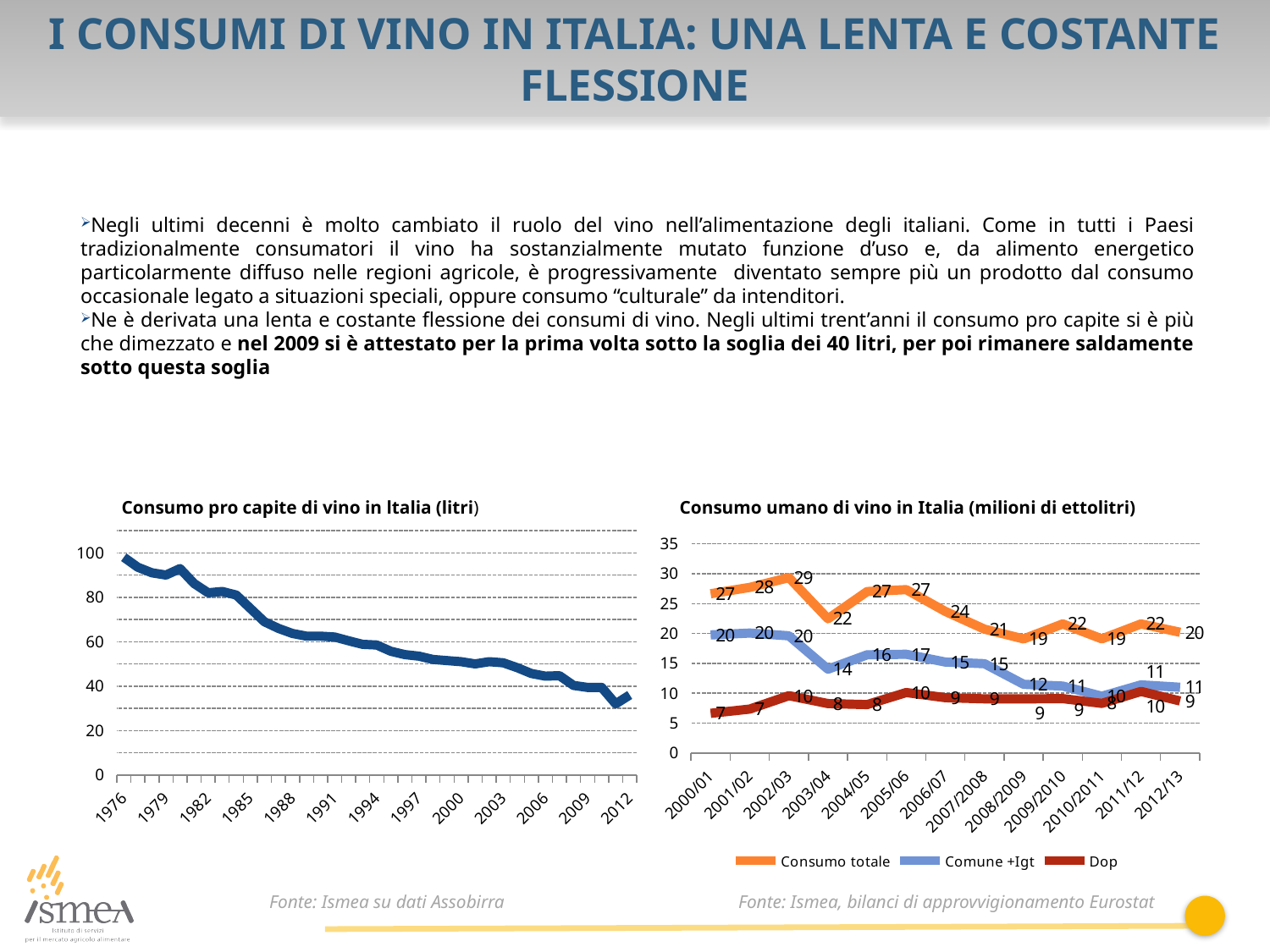
How many series does the legend of the chart 'Consumo umano di vino in Italia (milioni di ettolitri)' list? 3 In the chart 'Consumo umano di vino in Italia (milioni di ettolitri)', in which year does Consumo totale reach its highest value? 2002/03 How many years are plotted on the x axis of the chart 'Consumo umano di vino in Italia (milioni di ettolitri)'? 13 In the chart 'Consumo pro capite di vino in Italia (litri)', do the values rise or fall from 1976 to 2012? fall In the chart 'Consumo umano di vino in Italia (milioni di ettolitri)', what is the difference between Consumo totale and Comune +Igt in 2012/13? 9 In the chart 'Consumo pro capite di vino in Italia (litri)', is the value for 1976 greater or less than 80? greater In the chart 'Consumo pro capite di vino in Italia (litri)', is the value for 2012 greater or less than 40? less In the chart 'Consumo umano di vino in Italia (milioni di ettolitri)', what is the value of Dop for 2000/01? 7 What kind of chart is 'Consumo pro capite di vino in Italia (litri)'? line chart In the chart 'Consumo umano di vino in Italia (milioni di ettolitri)', what is the value of Consumo totale for 2002/03? 29 In the chart 'Consumo umano di vino in Italia (milioni di ettolitri)', is Consumo totale higher in 2005/06 or in 2006/07? 2005/06 In the chart 'Consumo umano di vino in Italia (milioni di ettolitri)', what is the value of Comune +Igt for 2003/04? 14